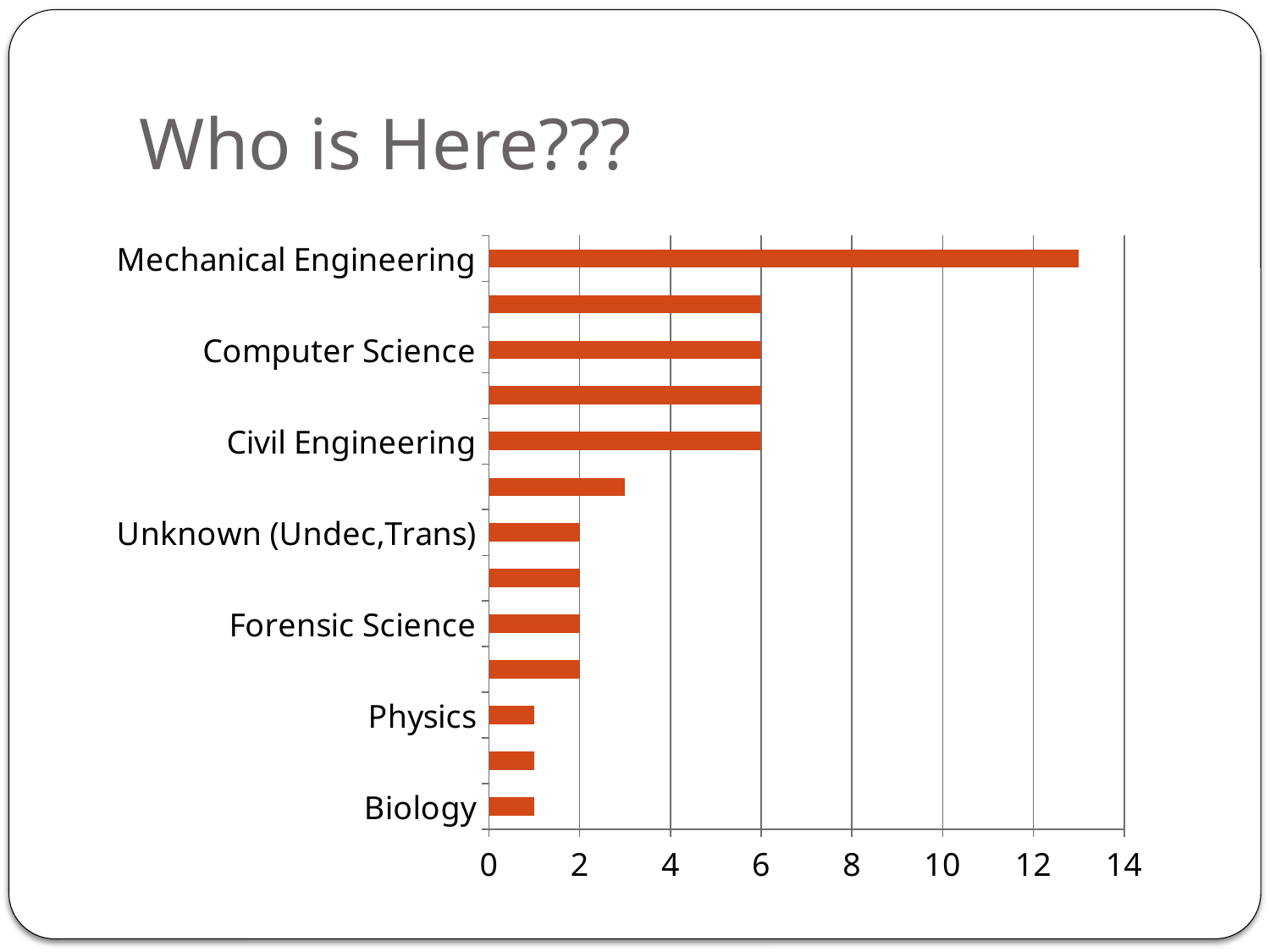
What type of chart is shown on the slide? bar chart What is the value for Civil Engineering? 6 What is the value for Forensic Science? 2 Is the value for Mechanical Engineering greater or less than 12? greater Which is larger, the value for Mechanical Engineering or the value for Computer Science? Mechanical Engineering What is the difference between the values for Civil Engineering and Forensic Science? 4 Which category has the longest bar in the chart? Mechanical Engineering What is the value for Unknown (Undec,Trans)? 2 What is the value for Computer Science? 6 How many bars are plotted in the chart? 13 What is the title of the slide containing the chart? Who is Here??? Is the value for Physics greater or less than 2? less